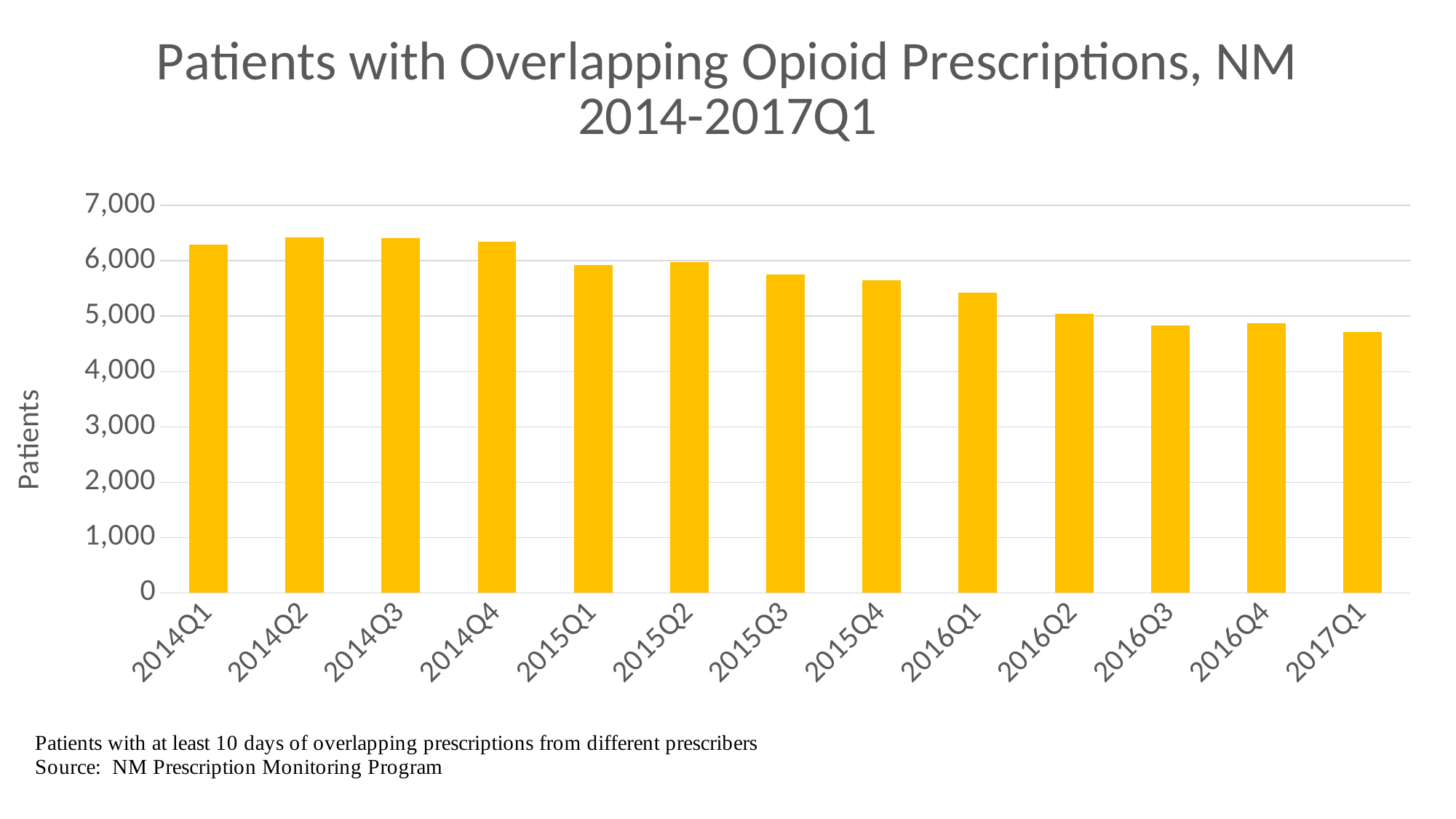
What kind of chart is shown on the slide? bar chart Which is larger, the value for 2014Q1 or the value for 2017Q1? 2014Q1 What is the source of the data cited on the slide? NM Prescription Monitoring Program Is the value for 2015Q3 greater or less than 6,000? less Is the value for 2016Q1 greater or less than 5,000? greater Is the value for 2014Q1 greater or less than 6,000? greater Which is larger, the value for 2015Q1 or the value for 2016Q1? 2015Q1 Do the values generally rise or fall from 2014Q1 to 2017Q1? fall What is the label on the vertical axis? Patients How many quarters are plotted on the x axis? 13